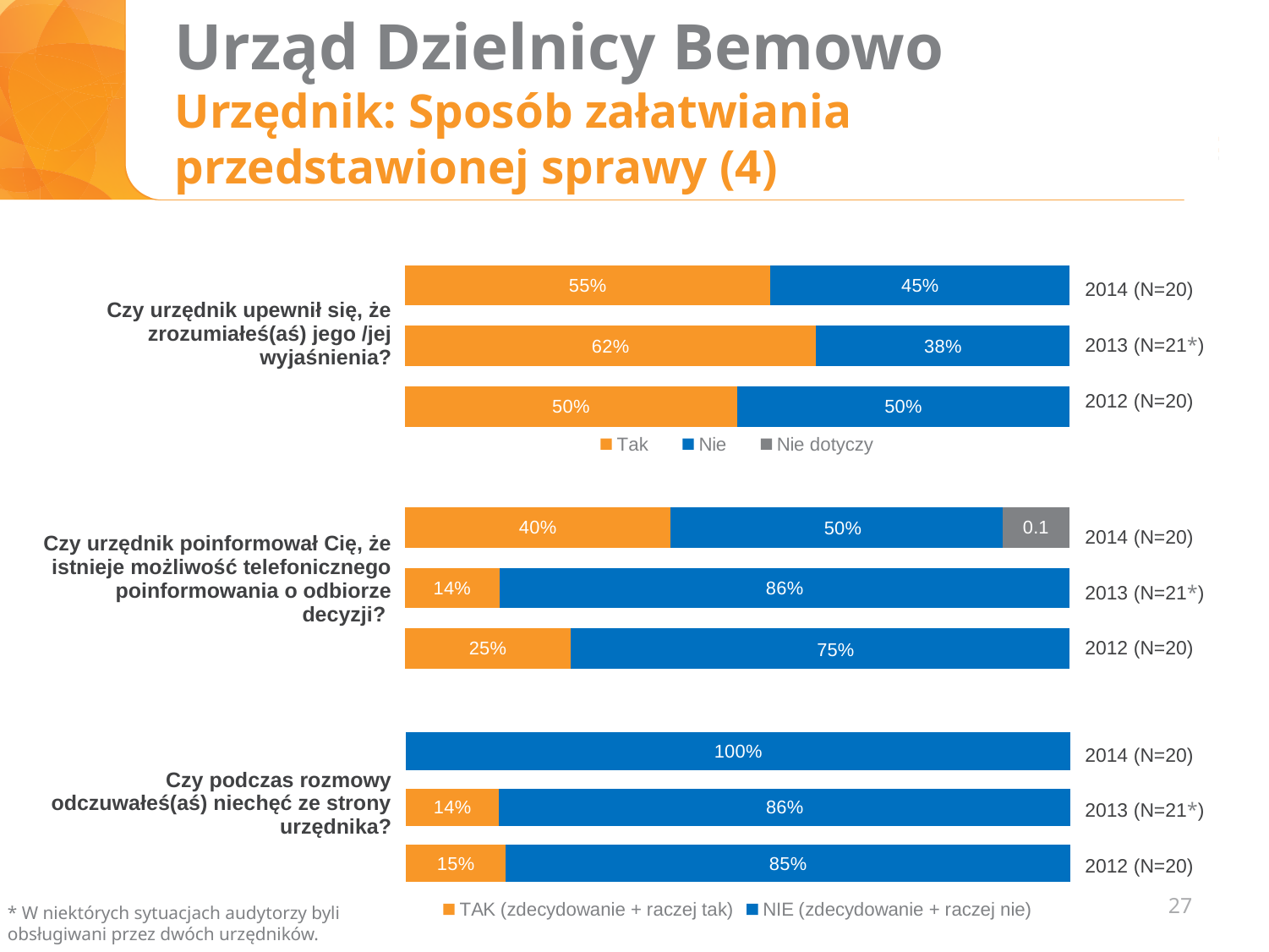
In the bottom chart (Czy podczas rozmowy odczuwałeś(aś) niechęć ze strony urzędnika?), is the NIE value for 2013 (N=21*) larger or smaller than the NIE value for 2012 (N=20)? larger What type of chart is used on this slide? Stacked bar chart In the middle chart (Czy urzędnik poinformował Cię, że istnieje możliwość telefonicznego poinformowania o odbiorze decyzji?), what is the Tak value for 2012 (N=20)? 25% In the middle chart (Czy urzędnik poinformował Cię, że istnieje możliwość telefonicznego poinformowania o odbiorze decyzji?), what is the difference between the Tak values for 2014 (N=20) and 2012 (N=20)? 15% In the bottom chart (Czy podczas rozmowy odczuwałeś(aś) niechęć ze strony urzędnika?), what is the TAK value for 2012 (N=20)? 15% In the middle chart (Czy urzędnik poinformował Cię, że istnieje możliwość telefonicznego poinformowania o odbiorze decyzji?), what is the Nie value for 2013 (N=21*)? 86% In the top chart (Czy urzędnik upewnił się, że zrozumiałeś(aś) jego /jej wyjaśnienia?), which year has the highest Tak value? 2013 (N=21*) In the top chart (Czy urzędnik upewnił się, że zrozumiałeś(aś) jego /jej wyjaśnienia?), how many entries does the legend list? 3 In the top chart (Czy urzędnik upewnił się, że zrozumiałeś(aś) jego /jej wyjaśnienia?), what is the Nie value for 2013 (N=21*)? 38% In the middle chart (Czy urzędnik poinformował Cię, że istnieje możliwość telefonicznego poinformowania o odbiorze decyzji?), which year has the lowest Tak value? 2013 (N=21*) In the bottom chart (Czy podczas rozmowy odczuwałeś(aś) niechęć ze strony urzędnika?), what is the NIE value for 2014 (N=20)? 100% In the top chart (Czy urzędnik upewnił się, że zrozumiałeś(aś) jego /jej wyjaśnienia?), what is the Tak value for 2014 (N=20)? 55%